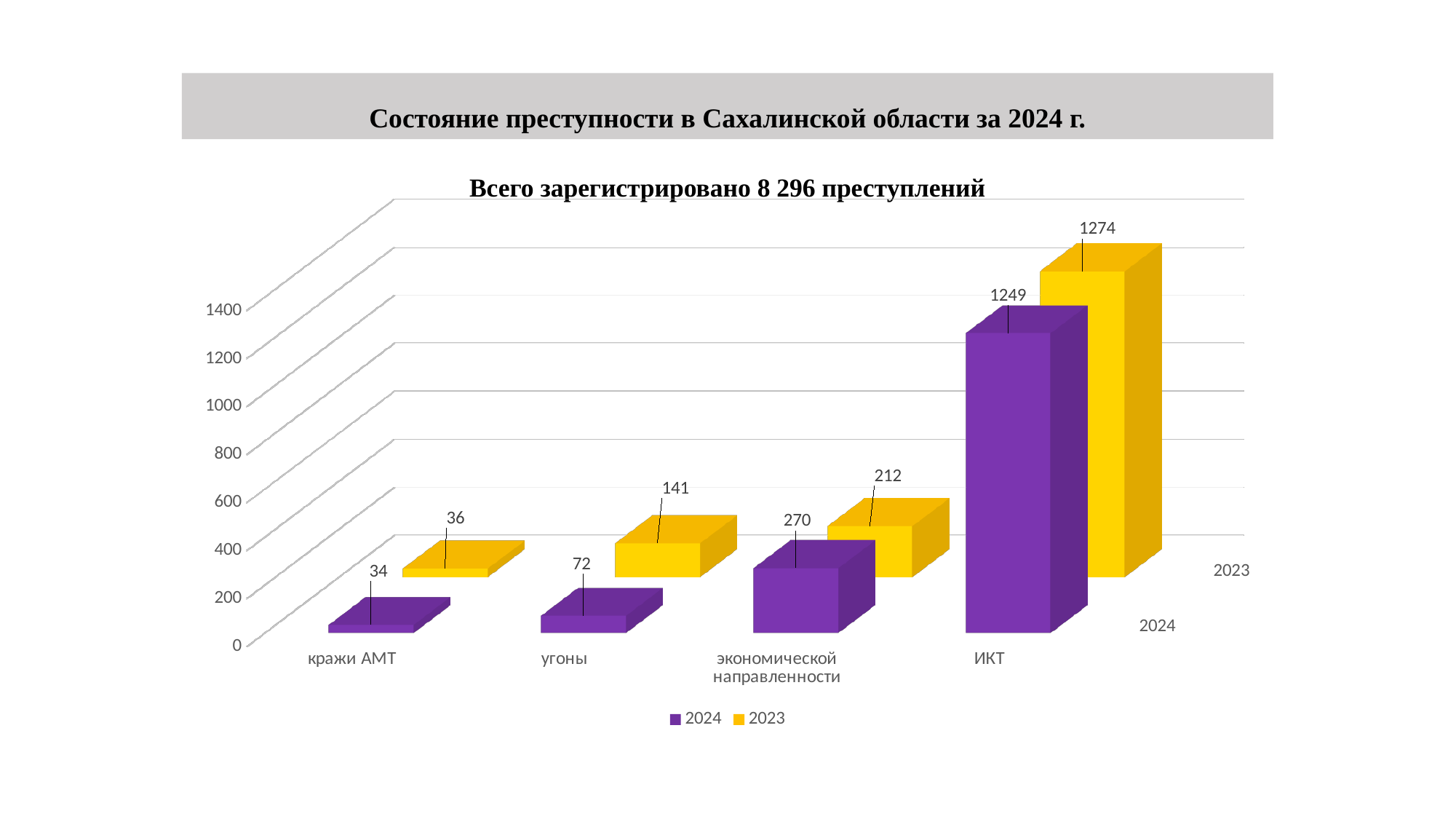
What is the value for ИКТ in the 2024 series? 1249 What is the value for экономической направленности in the 2024 series? 270 For экономической направленности, which series has the larger value, 2024 or 2023? 2024 What is the difference between the 2023 and 2024 values for угоны? 69 How many categories are shown on the x axis? 4 What is the value for кражи АМТ in the 2023 series? 36 What is the difference between the 2023 and 2024 values for ИКТ? 25 What kind of chart is shown on the slide? Bar chart What is the value for угоны in the 2023 series? 141 How many series does the legend list? 2 Which category has the highest value in the 2023 series? ИКТ Which category has the lowest value in the 2024 series? кражи АМТ